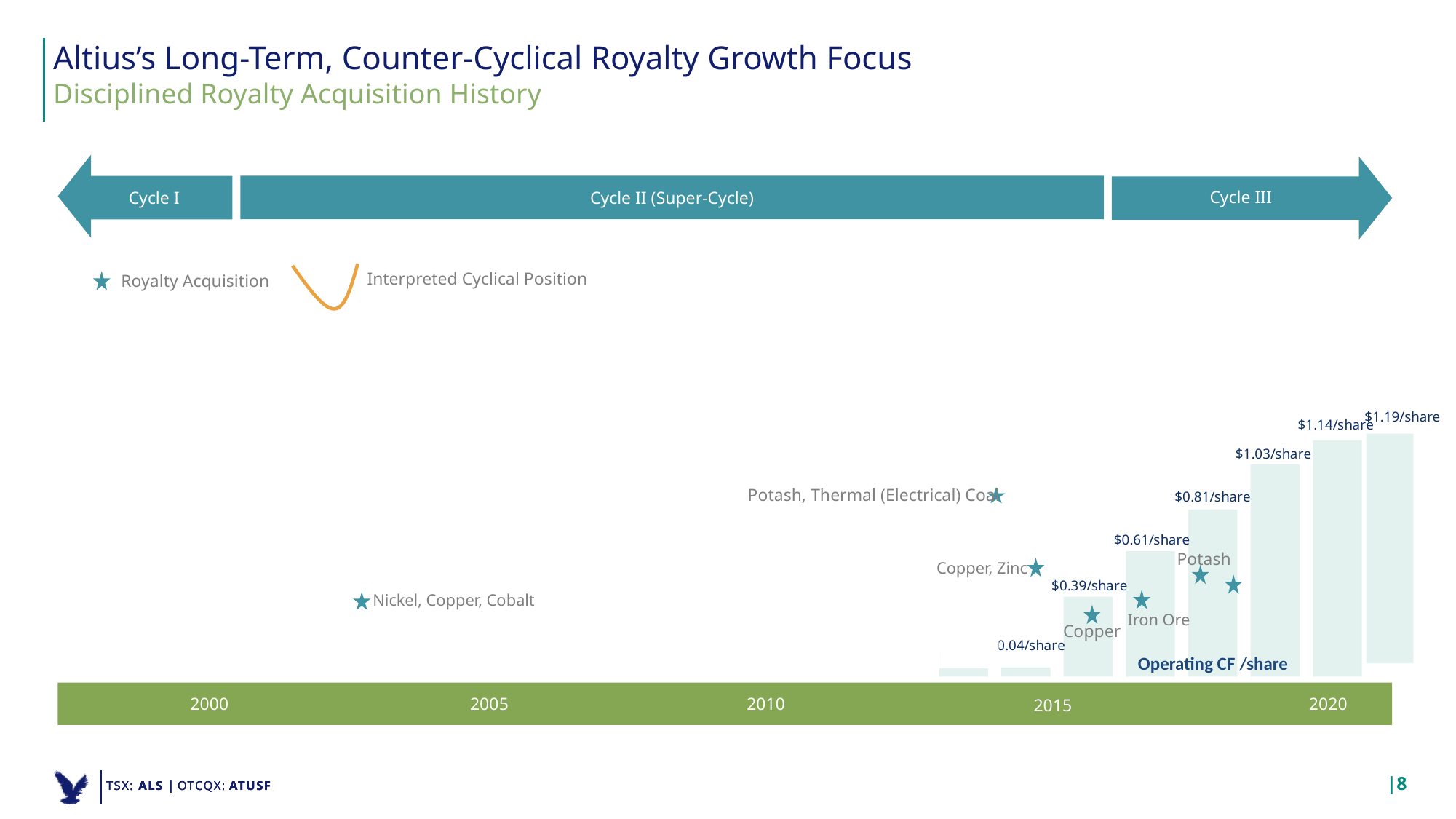
What is the difference between the two highest labelled Operating CF /share values, $1.19/share and $1.14/share? $0.05/share What is the highest Operating CF /share value labelled on the bars? $1.19/share What is the difference between the $1.03/share bar and the $0.81/share bar? $0.22/share What value is printed above the tallest bar in the chart? $1.19/share Do the Operating CF /share bars rise or fall moving from left to right along the timeline? rise According to the legend, what does the star symbol represent? Royalty Acquisition What metric do the bars in the chart represent, according to the label printed on the chart? Operating CF /share Which is larger, the bar labelled $0.61/share or the bar labelled $0.39/share? $0.61/share What is the difference between the $0.81/share bar and the $0.61/share bar? $0.20/share How many bars are labelled with a value of $1.00/share or more? 3 What kind of chart shows the Operating CF /share values on the slide? bar chart